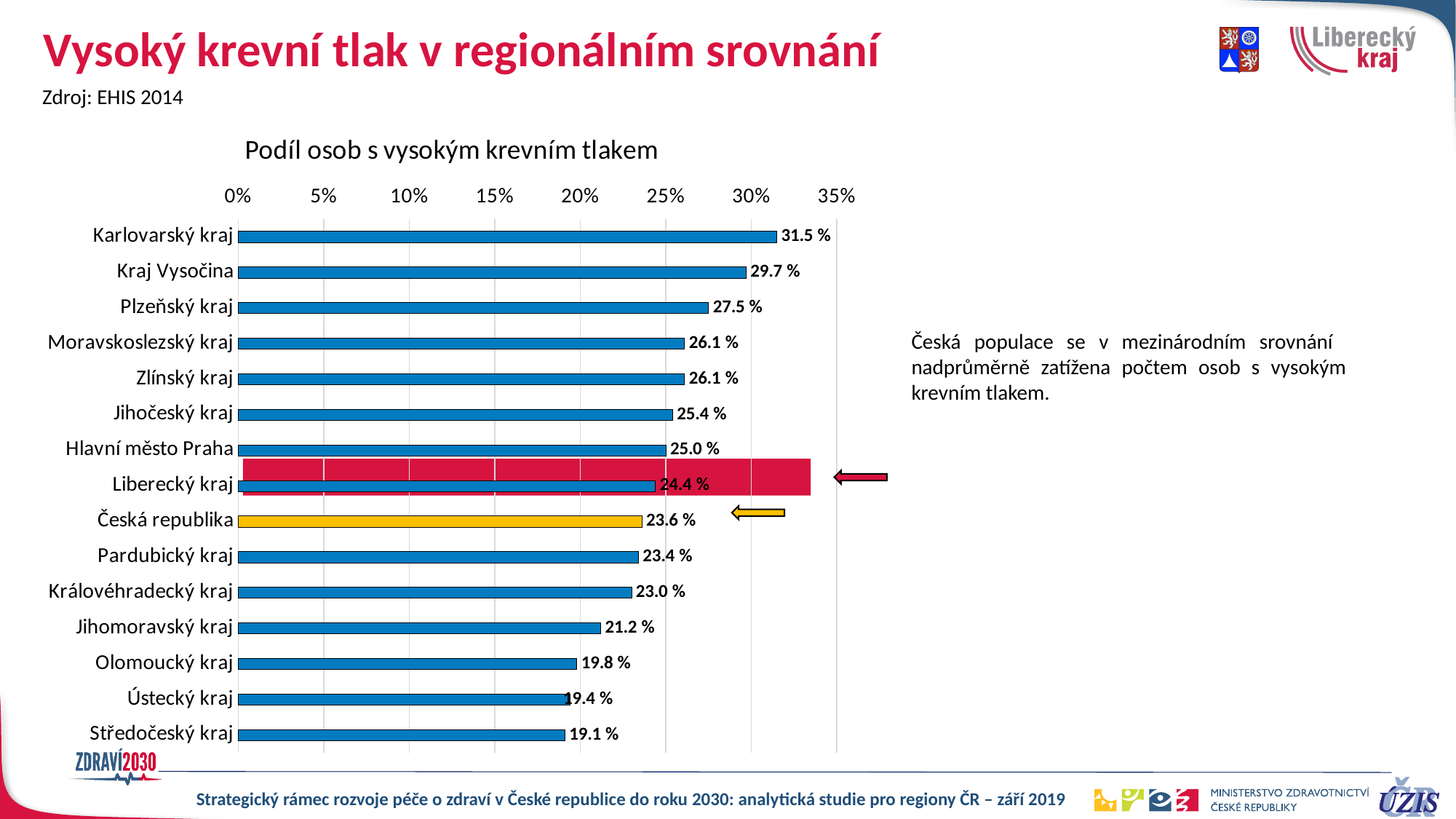
By how much does the value for Liberecký kraj exceed the value for Česká republika? 0.8 % What type of chart is shown on the slide? Bar chart Which has a larger value, Plzeňský kraj or Jihočeský kraj? Plzeňský kraj What is the title of the chart on the slide? Podíl osob s vysokým krevním tlakem What is the value for Liberecký kraj in the chart? 24.4 % How many categories (bars) are shown in the chart? 15 Which category has the lowest value in the chart? Středočeský kraj What is the difference between the values for Karlovarský kraj and Středočeský kraj? 12.4 % Which region has the highest share of people with high blood pressure in the chart? Karlovarský kraj What is the value for Česká republika in the chart? 23.6 % What is the value for Karlovarský kraj in the chart 'Podíl osob s vysokým krevním tlakem'? 31.5 % Is the value for Kraj Vysočina greater or less than 25%? greater